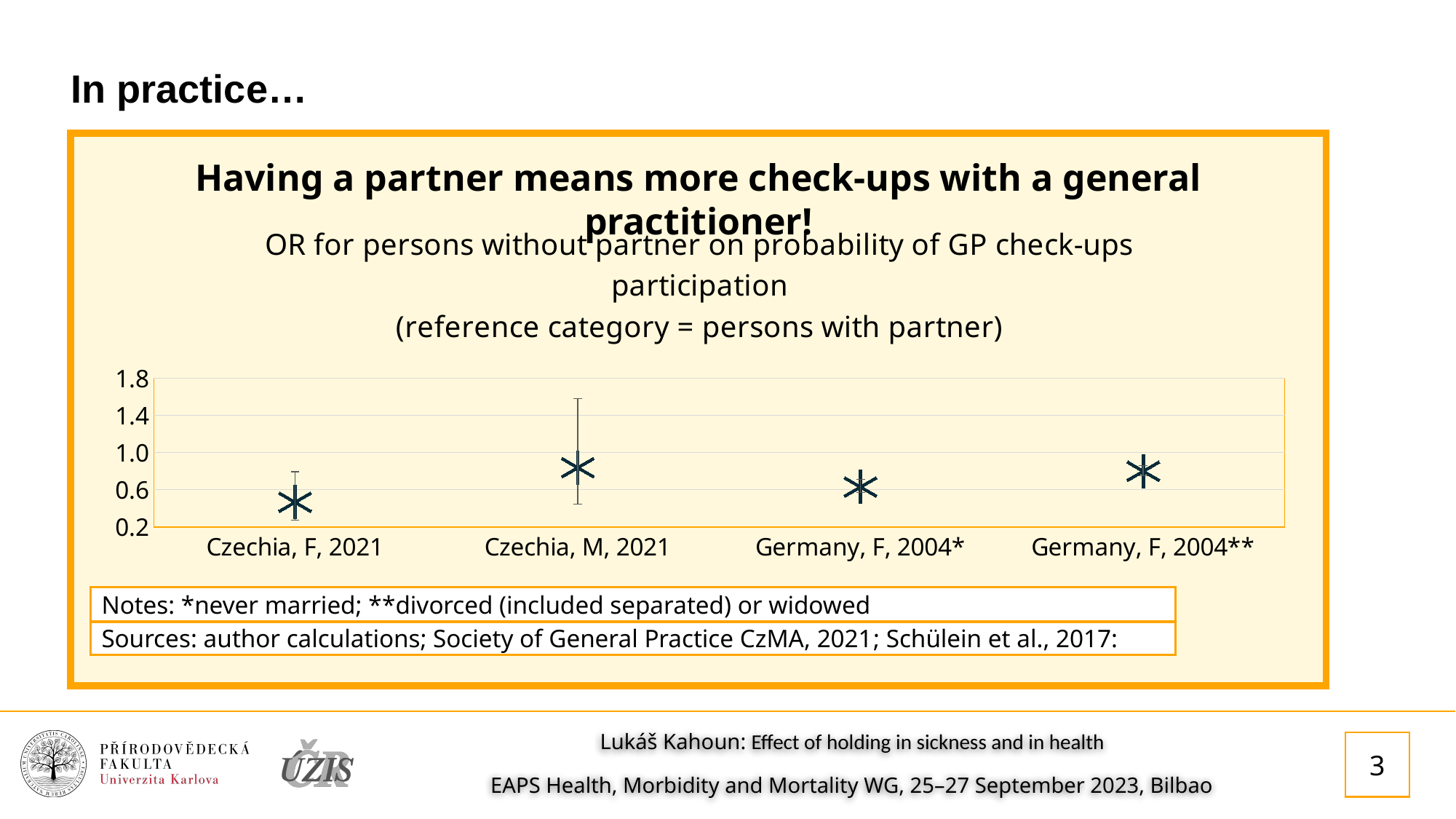
Is the value for Czechia, F, 2021 greater or less than 0.6? less What is the highest tick value shown on the y axis of the chart? 1.8 How many categories are plotted on the x axis of the chart? 4 What kind of chart is shown on the slide? A scatter (point) chart with error bars Which is larger, the value for Germany, F, 2004* or the value for Germany, F, 2004**? Germany, F, 2004** According to the chart subtitle, what is the reference category for the odds ratios? persons with partner Which is larger, the value for Czechia, M, 2021 or the value for Czechia, F, 2021? Czechia, M, 2021 Is the value for Czechia, M, 2021 greater or less than 1.0? less Is the value for Germany, F, 2004** greater or less than 1.0? less Which category has the lowest plotted odds ratio? Czechia, F, 2021